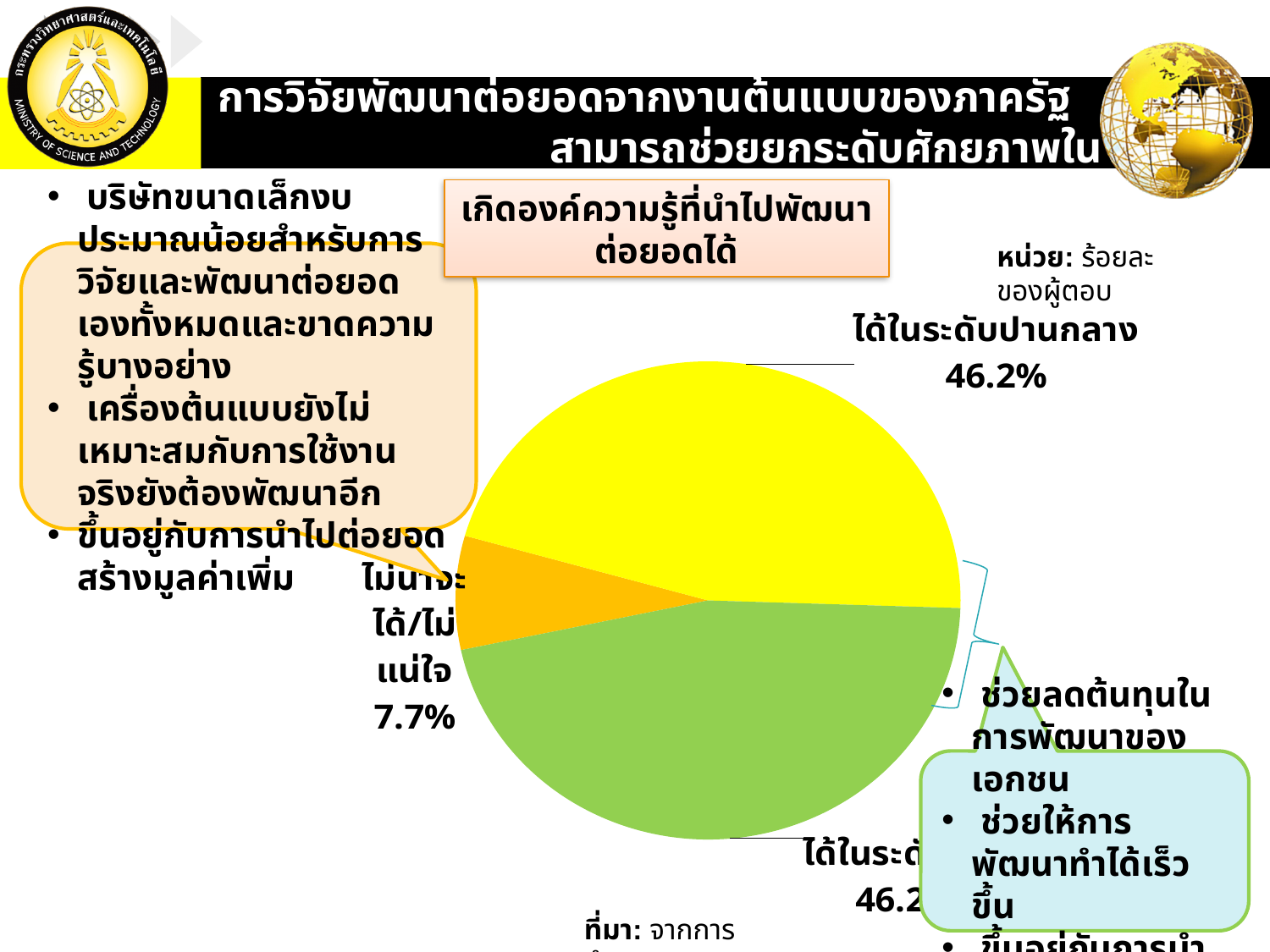
Which is larger in the pie chart: ได้ในระดับปานกลาง or ไม่น่าจะได้/ไม่แน่ใจ? ได้ในระดับปานกลาง What share of the pie does the ได้ในระดับปานกลาง slice represent? 46.2% What kind of chart is shown on the slide? pie chart Which slice of the pie chart is the smallest? ไม่น่าจะได้/ไม่แน่ใจ What is the title shown in the box above the pie chart? เกิดองค์ความรู้ที่นำไปพัฒนาต่อยอดได้ What is the difference in percentage points between ได้ในระดับปานกลาง and ไม่น่าจะได้/ไม่แน่ใจ? 38.5 How many slices does the pie chart have? 3 What percentage is shown for ได้ในระดับปานกลาง in the pie chart? 46.2% What percentage is shown for ไม่น่าจะได้/ไม่แน่ใจ in the pie chart? 7.7% What unit does the note above the pie chart say the values are in? ร้อยละของผู้ตอบ